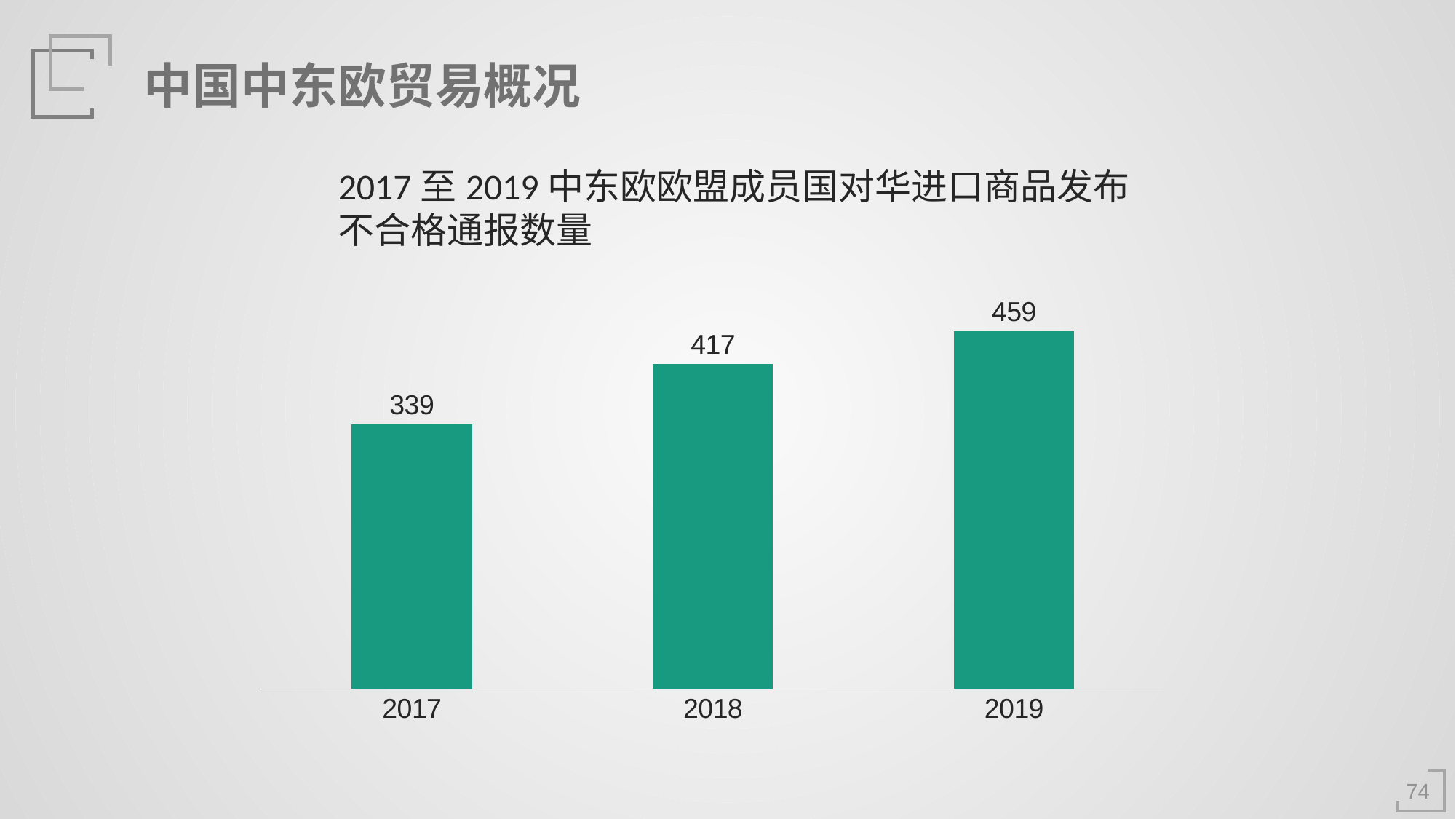
Which year has the highest value? 2019 What is the value for 2017? 339 What is the value for 2018? 417 What is the title of the chart? 2017 至 2019 中东欧欧盟成员国对华进口商品发布不合格通报数量 Which is larger, the value for 2018 or the value for 2019? 2019 What kind of chart is shown on the slide? bar chart Do the values rise or fall from 2017 to 2019? rise Which year has the lowest value? 2017 How many years are shown on the chart? 3 What is the difference between the values for 2018 and 2017? 78 What is the difference between the values for 2019 and 2017? 120 What is the value for 2019? 459